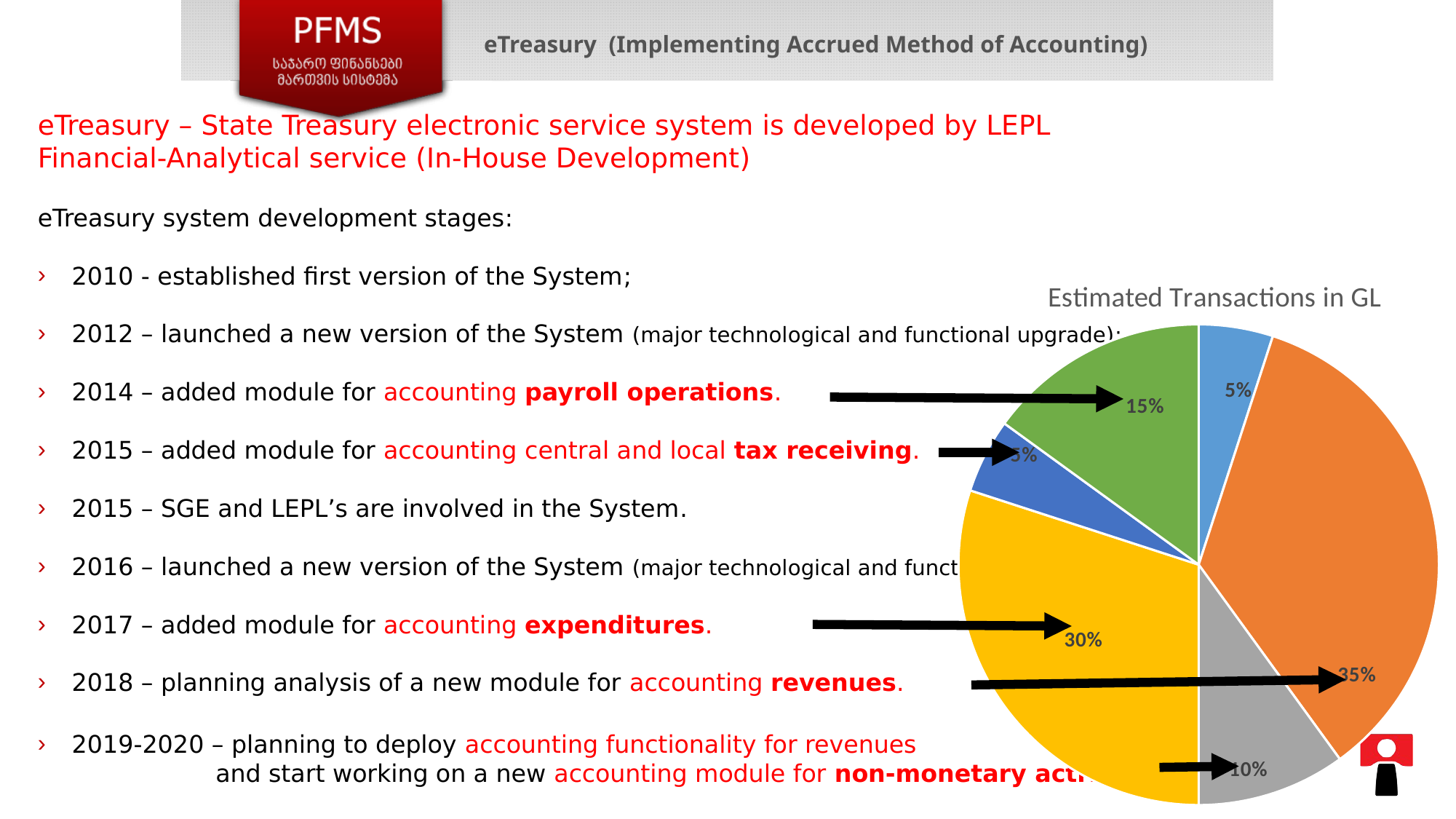
What percentage is shown on the yellow slice of the pie chart? 30% What is the largest percentage shown on the pie chart? 35% What percentage does the arrow from the 'accounting expenditures' bullet point to on the pie chart? 30% What percentage is shown on the orange slice of the pie chart? 35% What is the smallest percentage shown on the pie chart? 5% How many slices does the pie chart have? 6 What is the title of the chart on the slide? Estimated Transactions in GL What percentage is shown on the green slice of the pie chart? 15% What percentage is shown on the gray slice of the pie chart? 10% What is the difference between the orange slice (35%) and the yellow slice (30%) of the pie chart? 5% What kind of chart is shown on the slide? pie chart Which slice is larger in the pie chart, the green slice or the gray slice? green slice